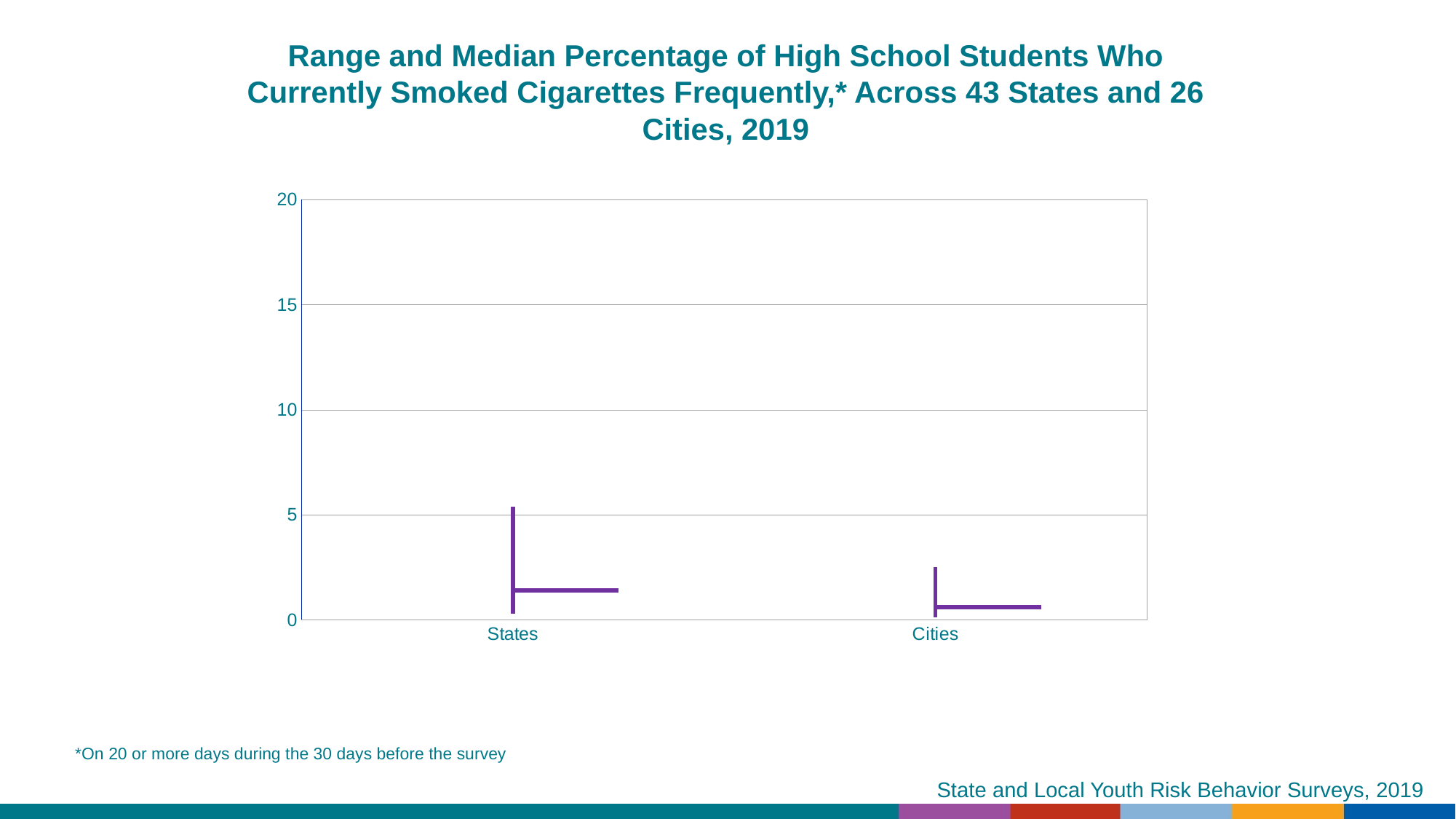
Which category has the higher maximum (top of the range) in the chart? States Is the median value for Cities greater or less than 5? less How many categories are shown on the x axis of the chart? 2 Is the maximum value of the range for Cities greater or less than 5? less Which category has the lower median value in the chart? Cities Is the maximum value of the range for Cities greater or less than 10? less What is the highest value shown on the y axis of the chart? 20 Which category has the higher median value in the chart? States What are the two categories shown on the x axis? States and Cities